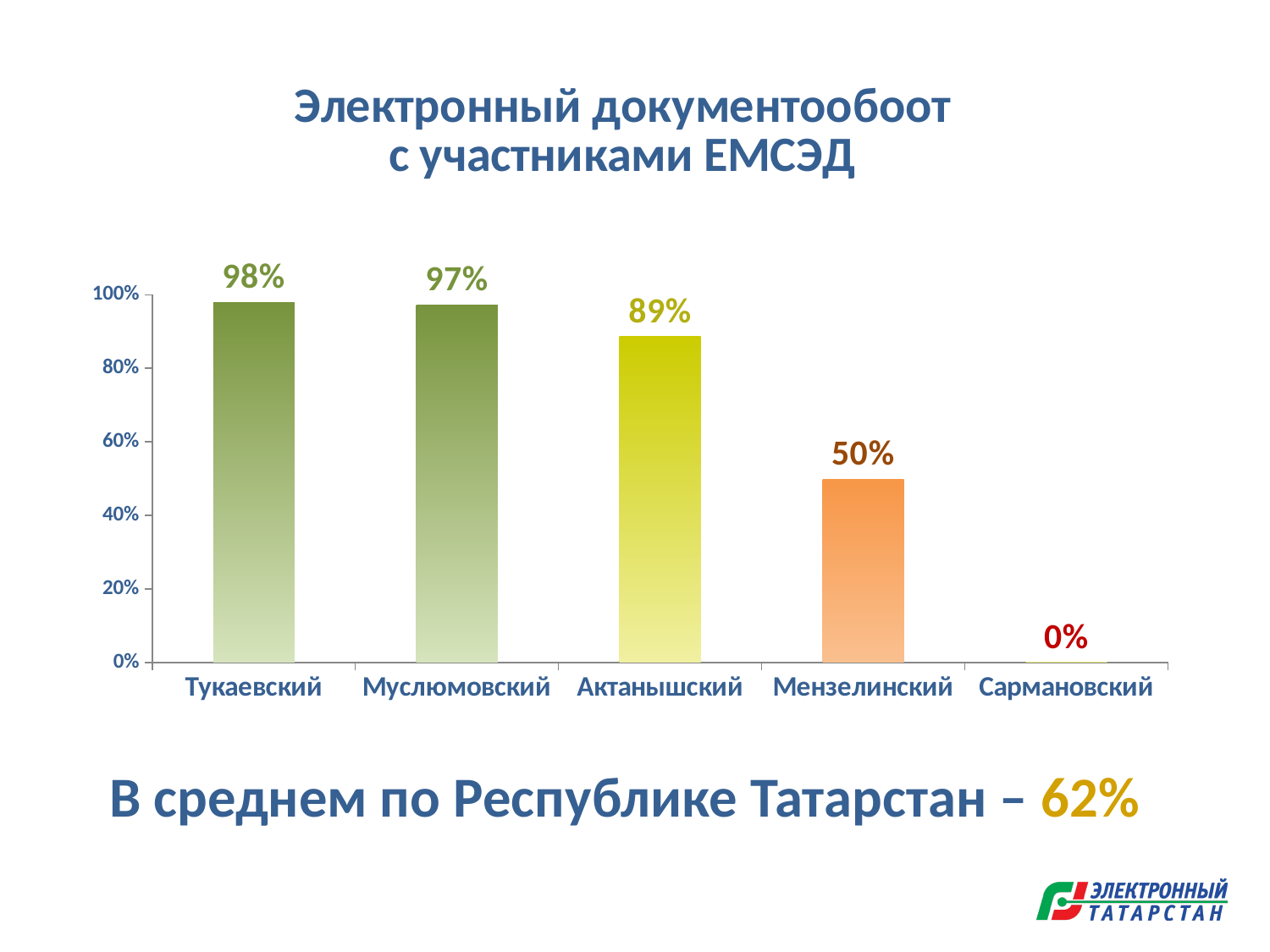
What is the value for Актанышский? 89% What is the difference between the values for Актанышский and Мензелинский? 39% What kind of chart is shown on the slide? bar chart What is the value for Мензелинский? 50% Which is larger, the value for Актанышский or the value for Мензелинский? Актанышский How many categories are shown on the x axis? 5 What is the value for Сармановский? 0% What is the value for Тукаевский? 98% What is the difference between the values for Муслюмовский and Мензелинский? 47% Do the values rise or fall from left to right along the x axis? fall Which category has the highest value? Тукаевский Which category has the lowest value? Сармановский